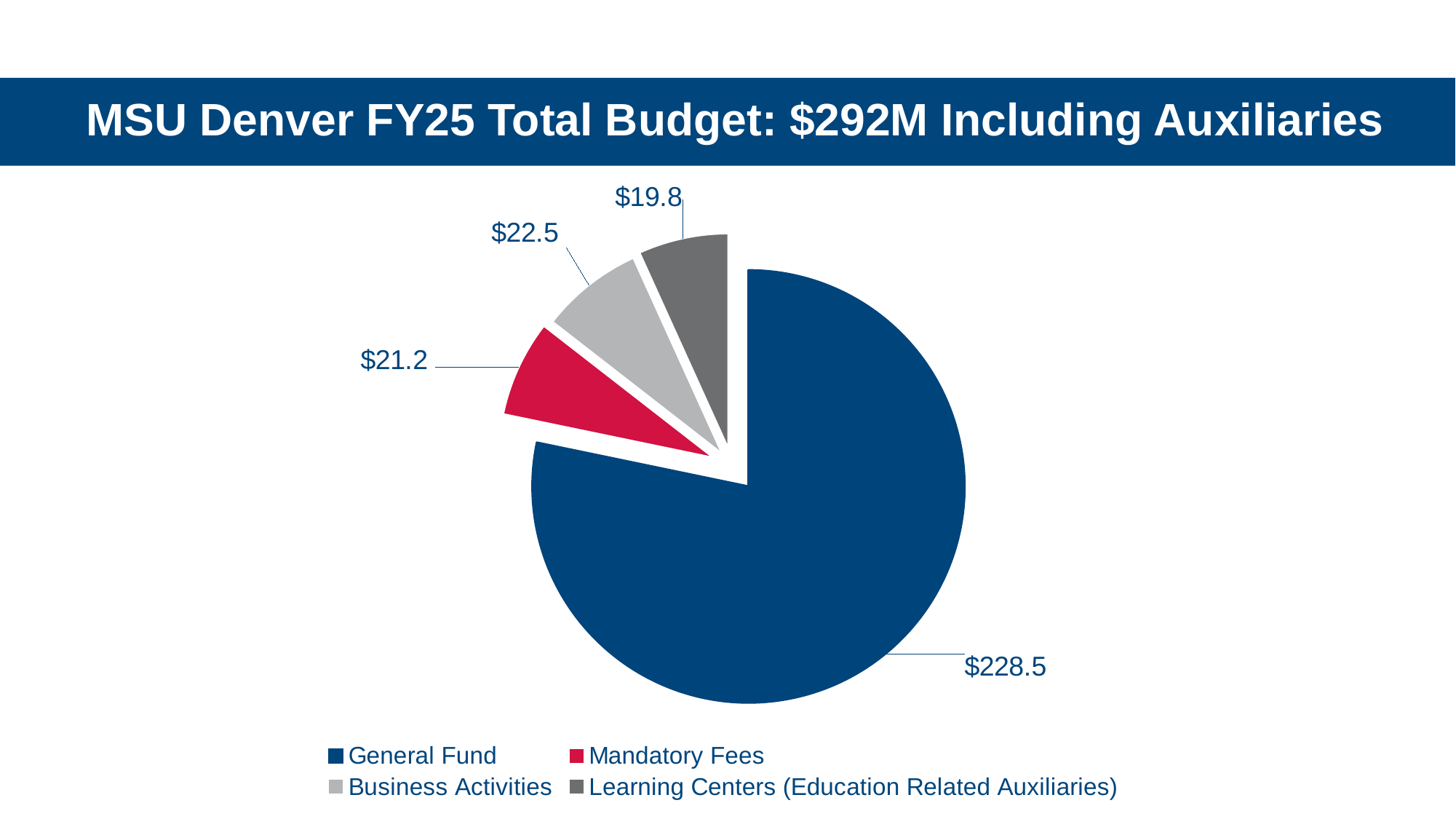
Which category has the smallest slice of the pie? Learning Centers (Education Related Auxiliaries) What is the difference between the Business Activities value and the Learning Centers value? $2.7 How many slices does the pie chart have? 4 Which is larger, Business Activities or Mandatory Fees? Business Activities What kind of chart is shown on the slide? Pie chart What is the value of the Business Activities slice? $22.5 Which category has the largest slice of the pie? General Fund What is the difference between the General Fund value and the Mandatory Fees value? $207.3 What is the value of the Learning Centers (Education Related Auxiliaries) slice? $19.8 What is the value of the Mandatory Fees slice? $21.2 What colour is the Mandatory Fees slice? Red What is the value of the General Fund slice? $228.5